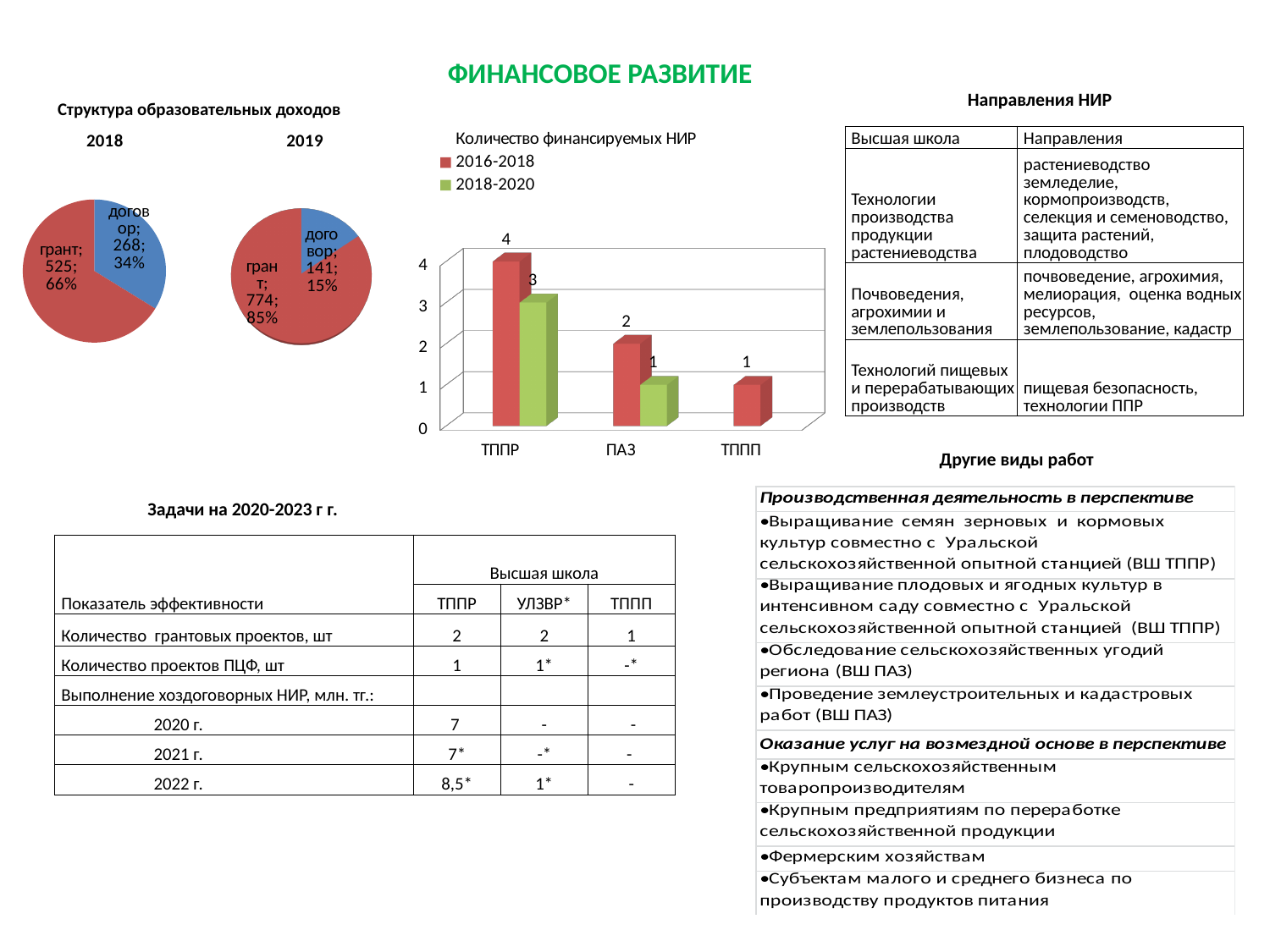
In the 2019 pie chart, which slice is larger, 'грант' or 'договор'? грант In the 'Количество финансируемых НИР' bar chart, what is the value for ТППР in the 2016-2018 series? 4 What kind of chart is 'Количество финансируемых НИР'? bar chart In the 2019 pie chart, what share does 'договор' have? 15% In the 2018 pie chart, what is the difference between the 'грант' value and the 'договор' value? 257 In the 'Количество финансируемых НИР' bar chart, how many categories are shown on the x axis? 3 In the 'Количество финансируемых НИР' bar chart, how many series does the legend list? 2 In the 'Количество финансируемых НИР' bar chart, which category has the highest value in the 2016-2018 series? ТППР In the 2018 pie chart under 'Структура образовательных доходов', what share does 'грант' have? 66% In the 'Количество финансируемых НИР' bar chart, what is the value for ПАЗ in the 2018-2020 series? 1 In the 2018 pie chart, what is the value shown for 'договор'? 268 In the 2019 pie chart, what is the value shown for 'грант'? 774